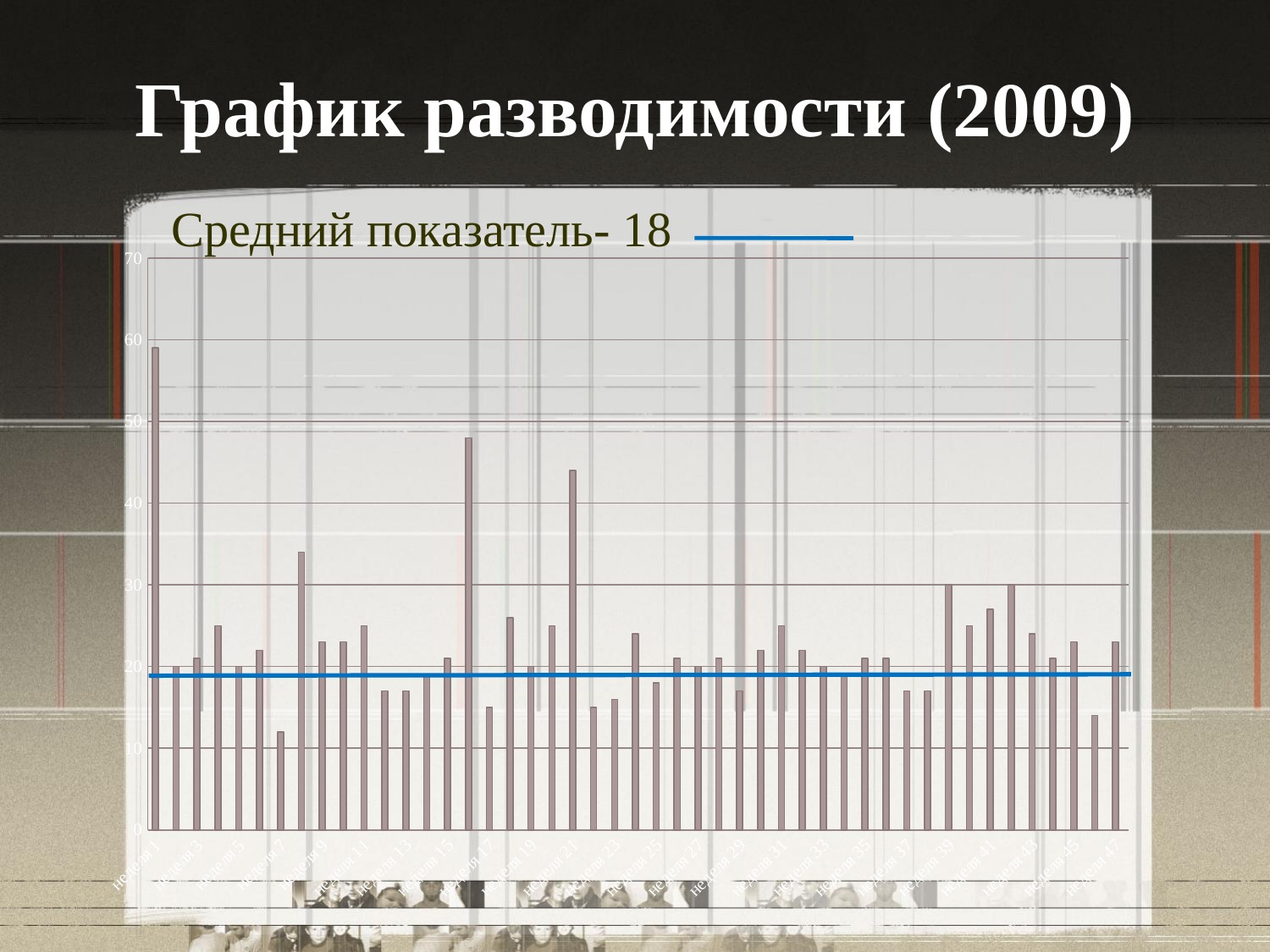
Is the value for неделя 21 greater or less than 40? greater What kind of chart is shown on the slide? bar chart Is the value for неделя 41 greater or less than 20? greater What average value (средний показатель) is stated above the chart? 18 Which is larger, the value for неделя 21 or the value for неделя 7? неделя 21 Which week has the highest bar in the chart? неделя 1 Is the value for неделя 17 greater or less than 20? less What is the highest value shown on the vertical axis of the chart? 70 What is the title of the chart on the slide? График разводимости (2009) Which is larger, the value for неделя 1 or the value for неделя 21? неделя 1